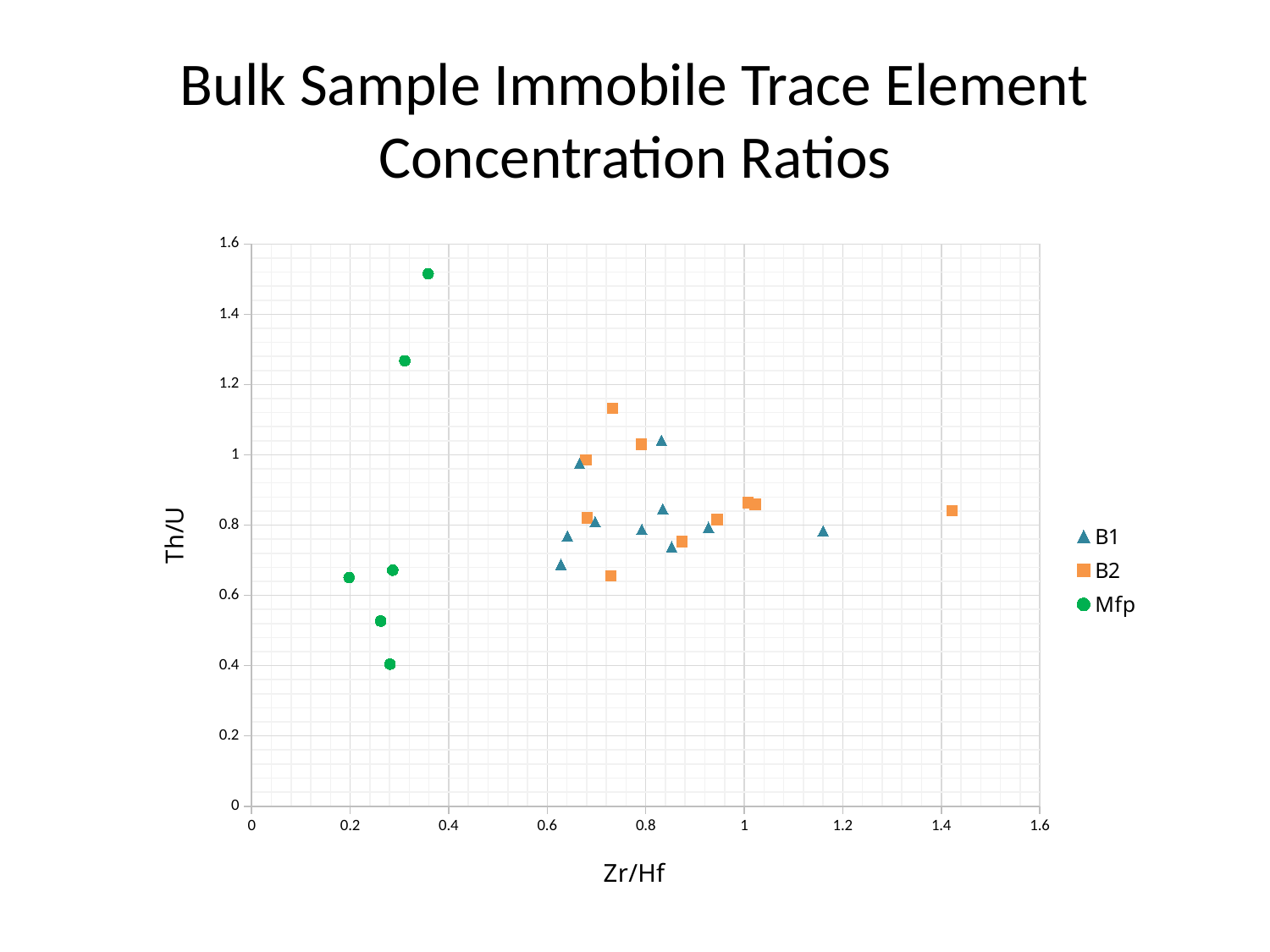
Which series contains the point with the largest Zr/Hf value? B2 Is the Th/U value of the lowest Mfp point greater or less than 0.6? less Which series contains the point with the lowest Th/U value? Mfp How many series does the legend list? 3 Which series contains the point with the highest Th/U value? Mfp Is the Th/U value of the highest Mfp point greater or less than 1.4? greater What is the label of the x axis? Zr/Hf What are the names of the series listed in the legend? B1, B2, Mfp How many Mfp points are plotted on the chart? 6 Is the Th/U value of the highest B2 point greater or less than 1? greater What kind of chart is shown on the slide? Scatter chart